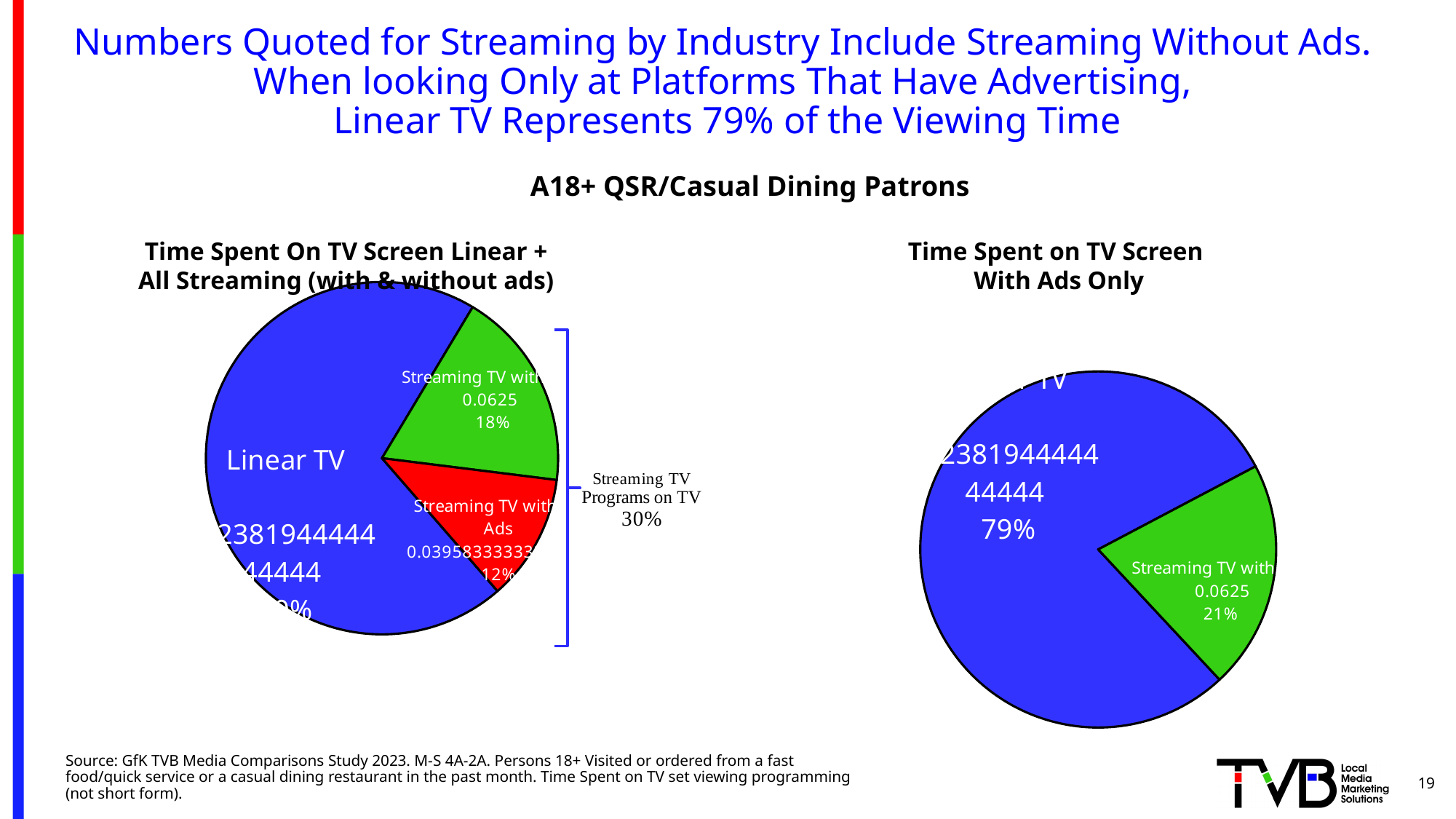
In the left pie chart (Linear + All Streaming), is the green slice or the red Streaming TV with Ads slice larger? The green slice What kind of charts are shown on the slide? Pie charts How many slices does the right pie chart (With Ads Only) have? 2 How many slices does the left pie chart (Linear + All Streaming) have? 3 In the right pie chart (With Ads Only), which category has the largest share? Linear TV In the right pie chart (Time Spent on TV Screen With Ads Only), what percentage is shown on the green slice? 21% What audience group is named in the subtitle above the two pie charts? A18+ QSR/Casual Dining Patrons In the right pie chart (With Ads Only), what is the difference in percentage points between the Linear TV slice and the green slice? 58% In the right pie chart (Time Spent on TV Screen With Ads Only), what share of viewing time does Linear TV represent? 79% In the left pie chart (Linear + All Streaming), what percentage does the bracket labelled 'Streaming TV Programs on TV' show? 30%